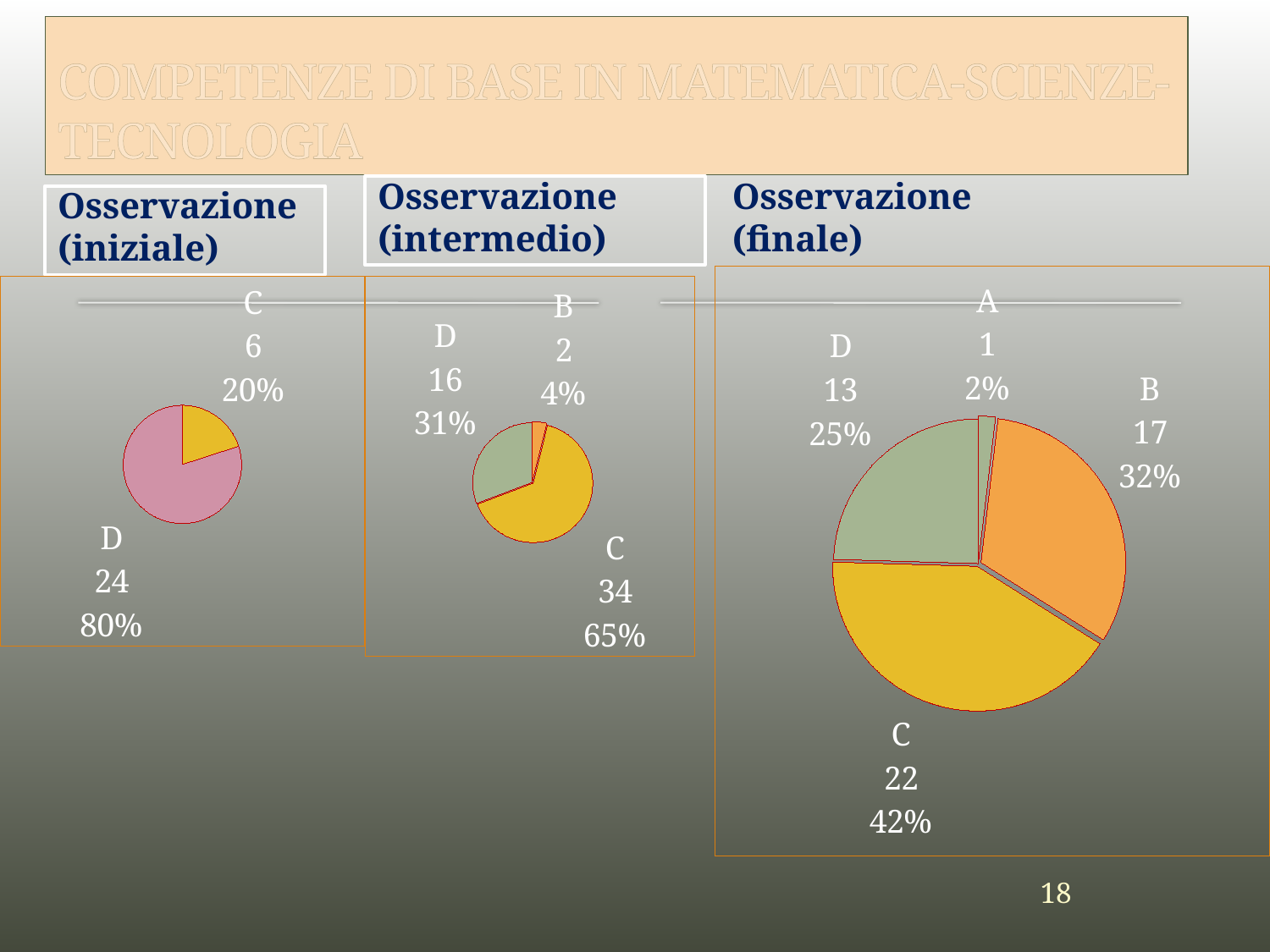
In the Osservazione (finale) chart, what is the difference between the values for C and D? 9 In the Osservazione (intermedio) chart, which category has the smallest slice? B In the Osservazione (finale) chart, what value is shown for category B? 17 In the Osservazione (finale) chart, which category has the largest slice? C In the Osservazione (finale) chart, how many categories are shown? 4 In the Osservazione (iniziale) chart, what share of the pie does category C represent? 20% In the Osservazione (intermedio) chart, which is larger, the value for D or the value for B? D In the Osservazione (intermedio) chart, what value is shown for category C? 34 In the Osservazione (iniziale) chart, what value is shown for category D? 24 In the Osservazione (finale) chart, what percentage is shown for category A? 2% In the Osservazione (intermedio) chart, what percentage is shown for category D? 31% What kind of chart is used in the Osservazione (iniziale) panel? Pie chart